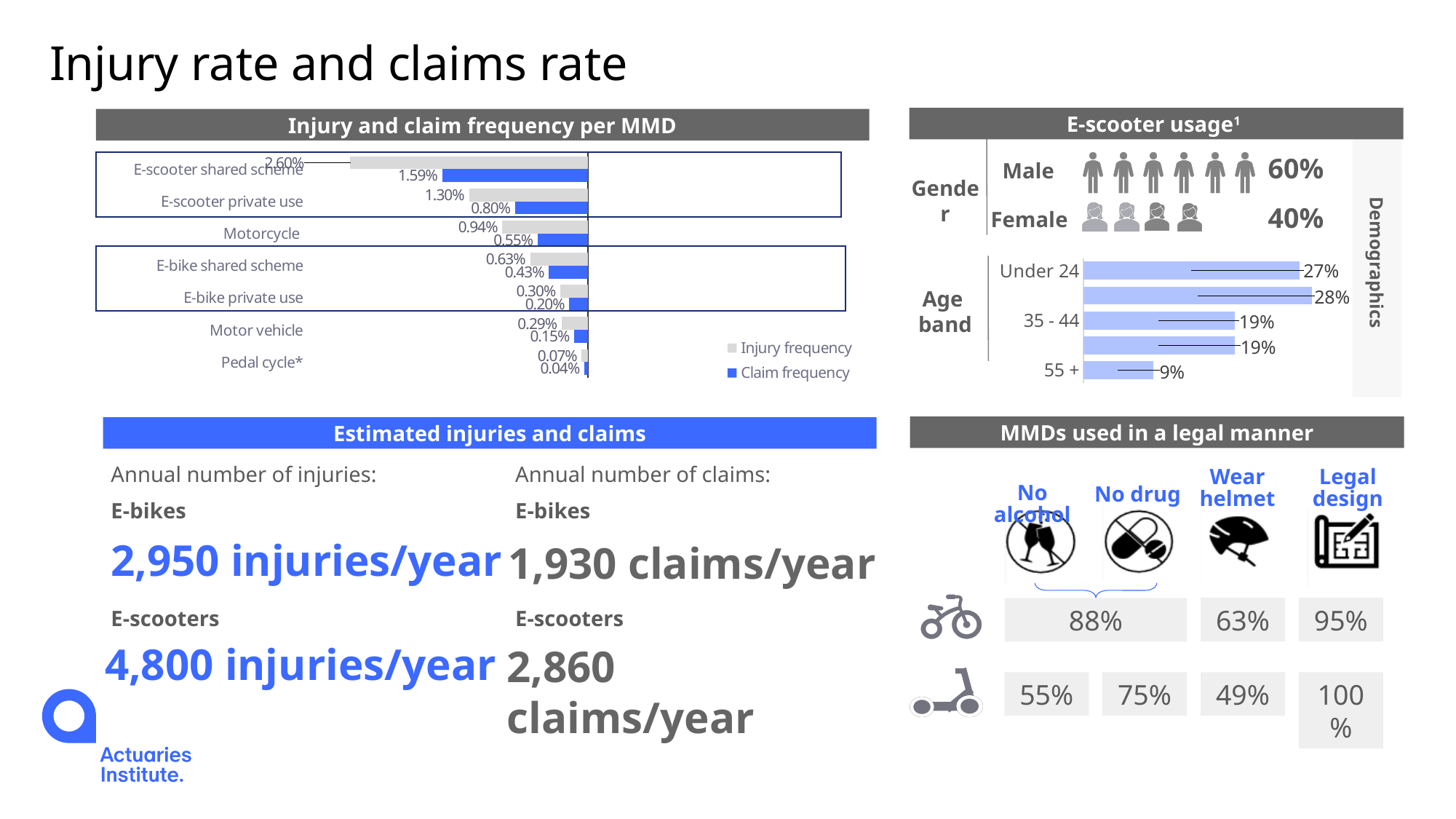
In the 'Injury and claim frequency per MMD' chart, which has a higher claim frequency: E-bike shared scheme or Motor vehicle? E-bike shared scheme In the 'Injury and claim frequency per MMD' chart, which category has the lowest claim frequency? Pedal cycle* In the 'Injury and claim frequency per MMD' chart, which colour represents Claim frequency? Blue In the Age band chart under 'E-scooter usage', what is the value for Under 24? 27% How many series does the legend of the 'Injury and claim frequency per MMD' chart list? 2 How many categories are shown in the 'Injury and claim frequency per MMD' chart? 7 In the Age band chart under 'E-scooter usage', what is the difference between the values for 35 - 44 and 55 +? 10% What type of chart is the 'Injury and claim frequency per MMD' chart? Bar chart In the 'Injury and claim frequency per MMD' chart, what is the claim frequency for Motorcycle? 0.55% In the 'Injury and claim frequency per MMD' chart, what is the difference between the injury frequency and the claim frequency for E-scooter private use? 0.50% In the 'Injury and claim frequency per MMD' chart, which category has the highest injury frequency? E-scooter shared scheme In the 'Injury and claim frequency per MMD' chart, what is the injury frequency for E-scooter shared scheme? 2.60%